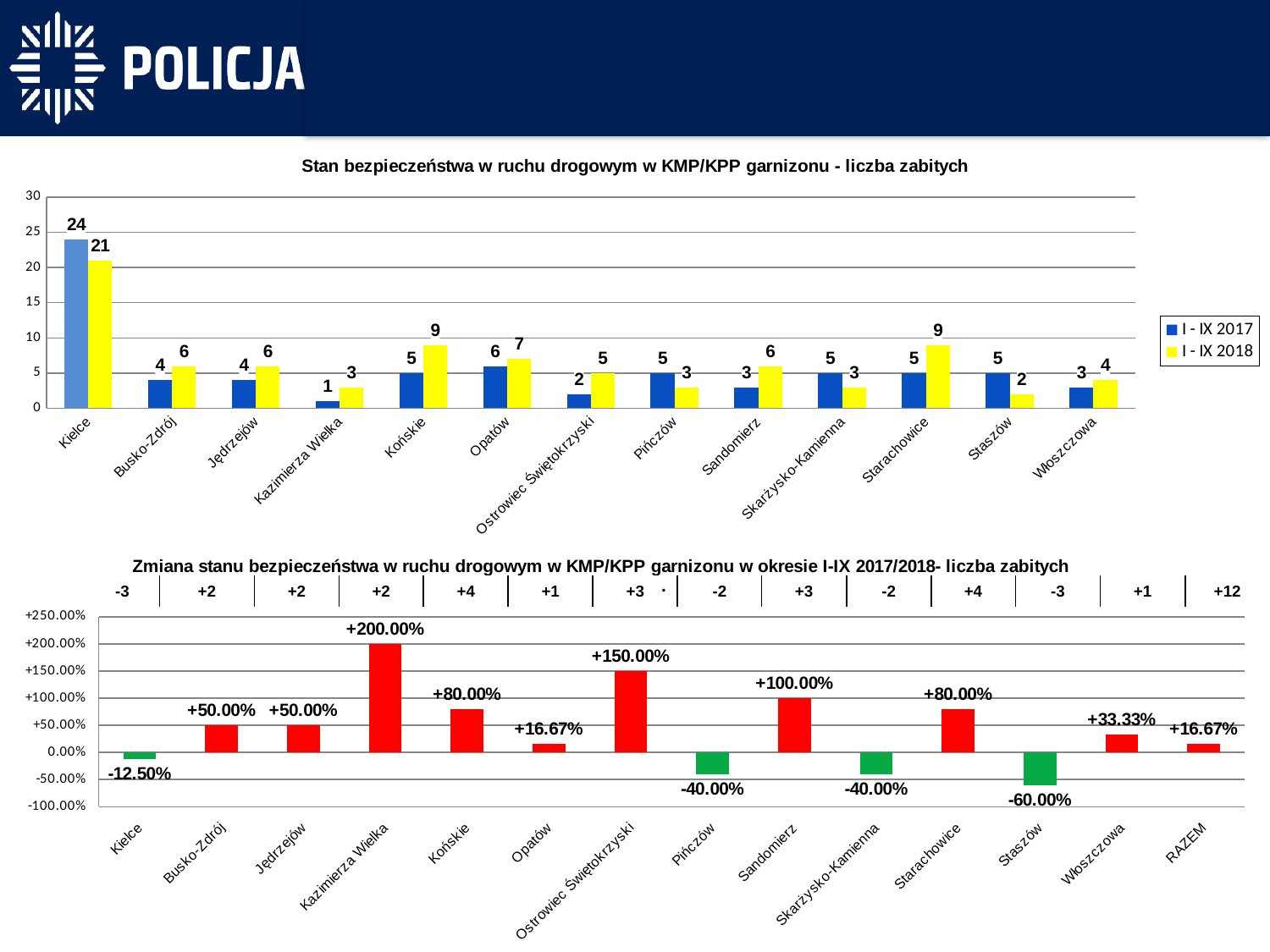
In the bottom chart, which category has the lowest value? Staszów How many categories are shown on the x axis of the top chart? 13 In the top chart, what is the difference between the I - IX 2017 and I - IX 2018 values for Kielce? 3 In the bottom chart, what is the value for RAZEM? +16.67% In the top chart, which category has the lowest value for I - IX 2017? Kazimierza Wielka In the top chart (Stan bezpieczeństwa w ruchu drogowym w KMP/KPP garnizonu - liczba zabitych), what is the value for Kielce in I - IX 2017? 24 How many series does the legend of the top chart list? 2 In the top chart, which category has the highest value for I - IX 2018? Kielce In the bottom chart (Zmiana stanu bezpieczeństwa w ruchu drogowym), what is the value for Kazimierza Wielka? +200.00% What kind of chart is the bottom chart? Bar chart In the top chart, which is larger for Staszów: the I - IX 2017 value or the I - IX 2018 value? I - IX 2017 In the top chart, what is the value for Starachowice in I - IX 2018? 9